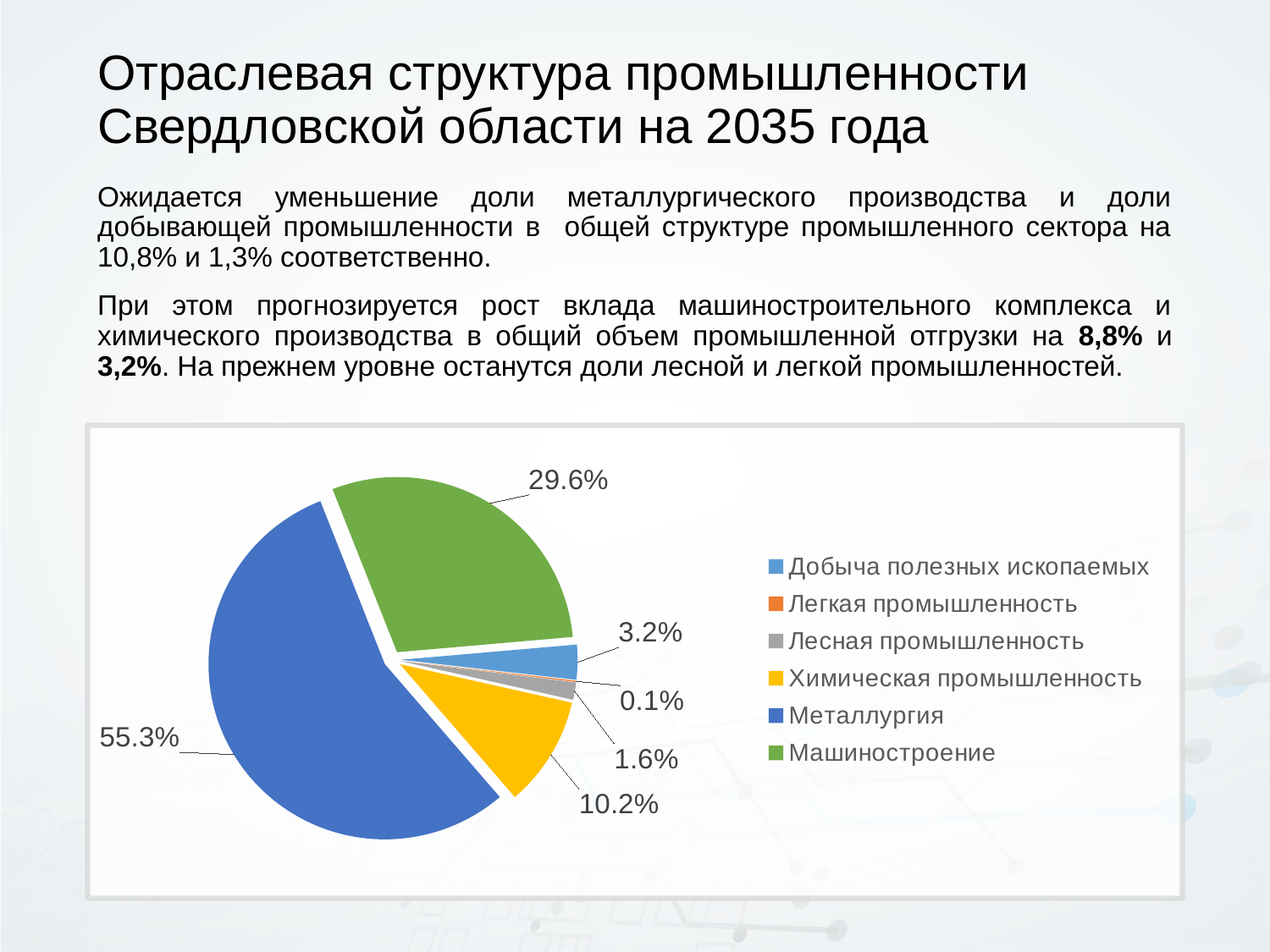
What share of the pie does Машиностроение have? 29.6% What share of the pie does Легкая промышленность have? 0.1% Which category has the largest slice of the pie? Металлургия What kind of chart is shown on the slide? pie chart What share of the pie does Металлургия have? 55.3% What share of the pie does Добыча полезных ископаемых have? 3.2% Which category has the smallest slice of the pie? Легкая промышленность What share of the pie does Химическая промышленность have? 10.2% Which is larger, the share of Химическая промышленность or the share of Добыча полезных ископаемых? Химическая промышленность What share of the pie does Лесная промышленность have? 1.6% How many categories does the pie chart show? 6 What is the difference between the shares of Металлургия and Машиностроение? 25.7%